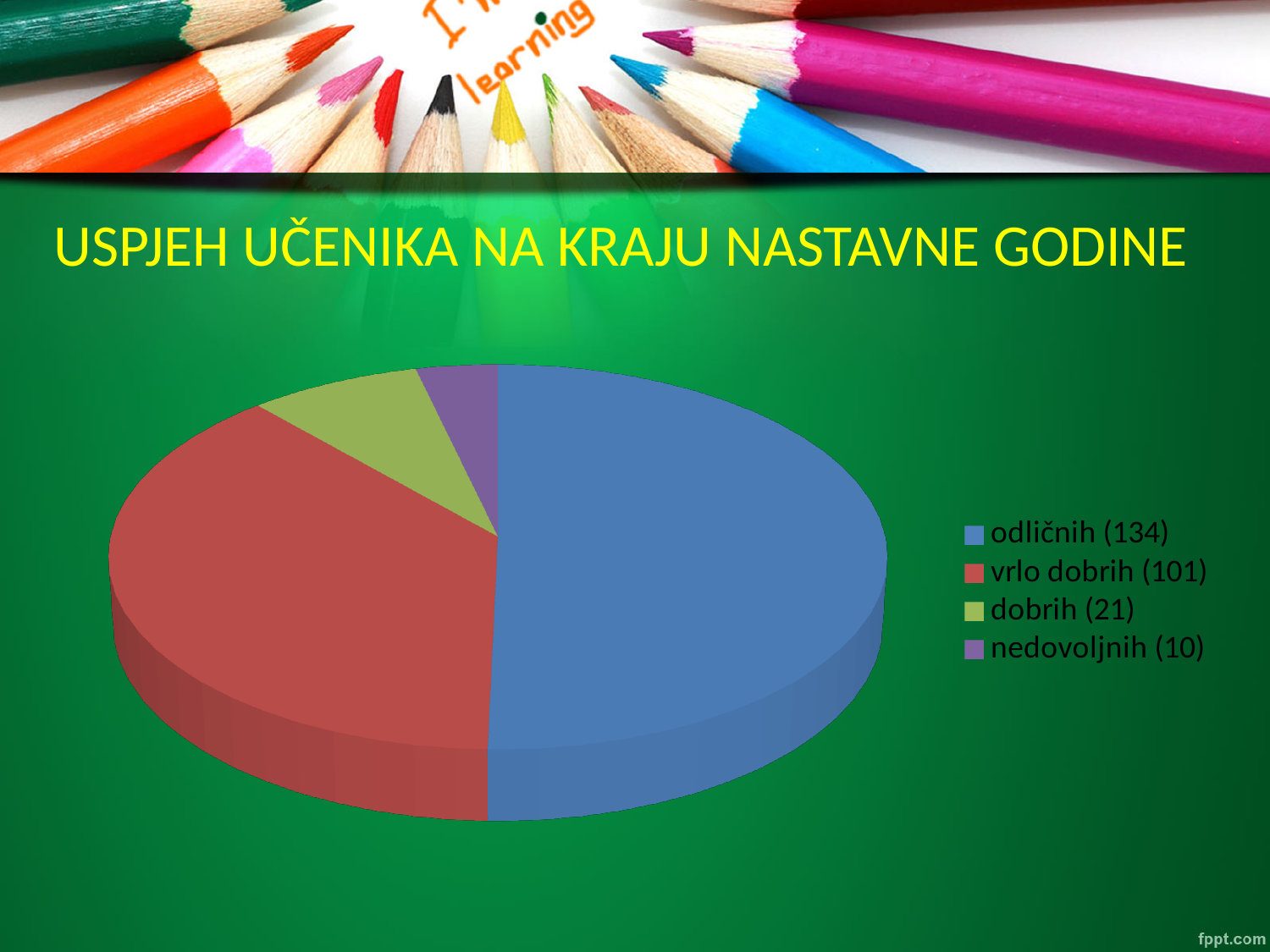
What colour is the 'vrlo dobrih' slice in the pie chart? red How many students are in the 'dobrih' category? 21 How many students are in the 'odličnih' category? 134 How many students are in the 'nedovoljnih' category? 10 What is the difference between the number of 'odličnih' and 'vrlo dobrih' students? 33 What kind of chart is shown on the slide? pie chart Which is larger, the 'dobrih' slice or the 'nedovoljnih' slice? dobrih Which category has the largest slice of the pie? odličnih Which category has the smallest slice of the pie? nedovoljnih How many categories does the pie chart have? 4 What is the title of the chart on the slide? USPJEH UČENIKA NA KRAJU NASTAVNE GODINE How many students are in the 'vrlo dobrih' category? 101